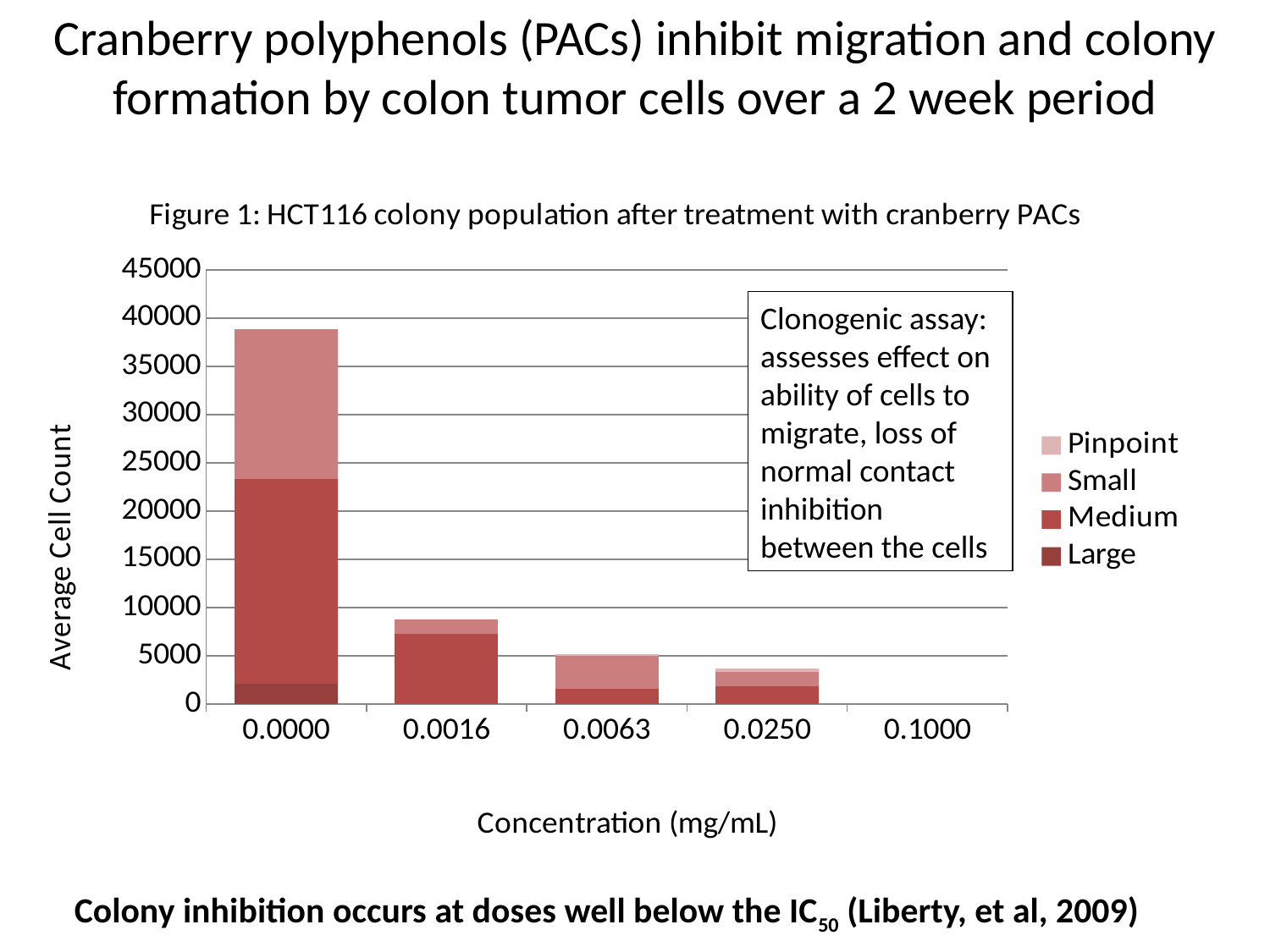
How many concentration categories are shown on the x axis? 5 Which has a larger total average cell count, concentration 0.0016 or 0.0063? 0.0016 Which concentration has the highest total average cell count? 0.0000 Is the total average cell count at concentration 0.0250 greater or less than 5000? less Which concentration has the lowest total average cell count? 0.1000 How many series does the legend list? 4 Is the total average cell count at concentration 0.0016 greater or less than 10000? less Is the total average cell count at concentration 0.0000 greater or less than 35000? greater What is the label of the x axis? Concentration (mg/mL) What is the title of the chart? Figure 1: HCT116 colony population after treatment with cranberry PACs Do the total average cell counts rise or fall as concentration increases along the x axis? fall What kind of chart is shown on the slide? stacked bar chart